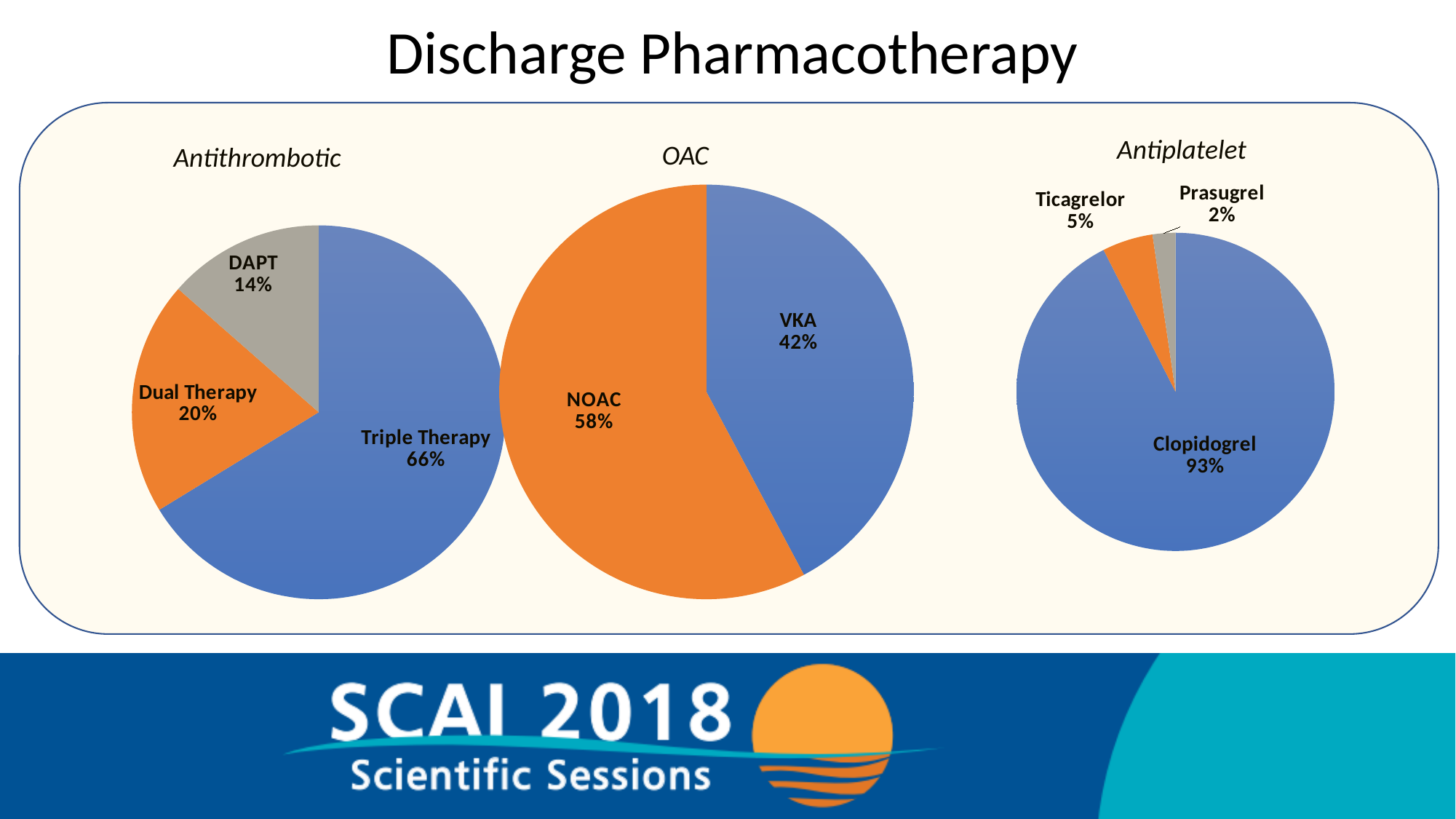
In the OAC pie chart, which is larger, NOAC or VKA? NOAC How many pie charts are shown on the slide? 3 In the Antiplatelet pie chart, what is the difference between the Ticagrelor and Prasugrel shares? 3% In the Antiplatelet pie chart, what share is Prasugrel? 2% In the Antithrombotic pie chart, which category has the smallest share? DAPT In the Antithrombotic pie chart, what share is Triple Therapy? 66% In the OAC pie chart, what share is NOAC? 58% In the OAC pie chart, how many slices are there? 2 What kind of chart is the Antithrombotic chart? Pie chart In the Antithrombotic pie chart, what is the difference between the Triple Therapy and Dual Therapy shares? 46%